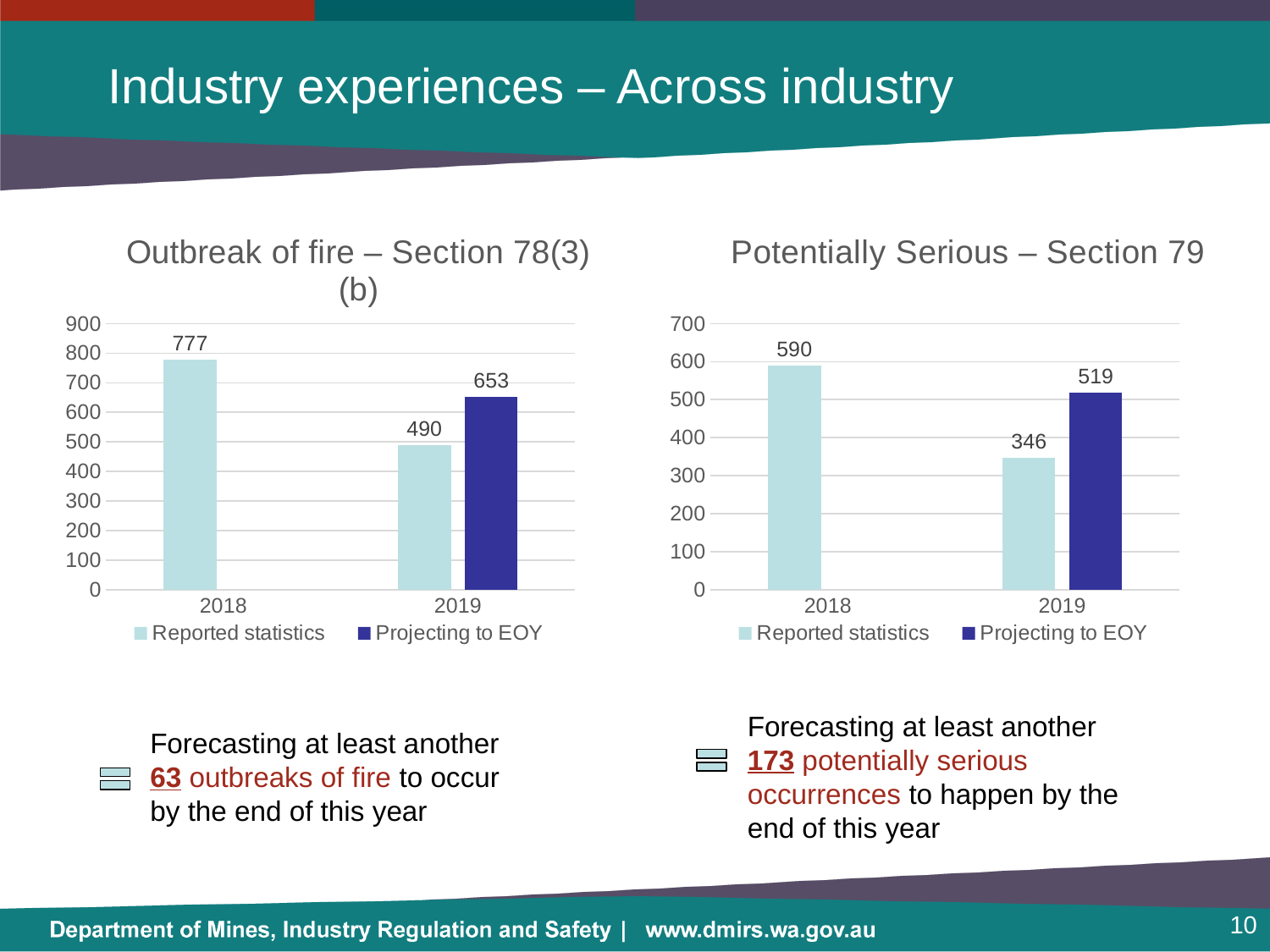
How many series does the legend of the 'Outbreak of fire – Section 78(3)(b)' chart list? 2 What kind of chart is the 'Potentially Serious – Section 79' chart? Bar chart In the 'Outbreak of fire – Section 78(3)(b)' chart, what is the Projecting to EOY value for 2019? 653 In the 'Potentially Serious – Section 79' chart, is the 2018 Reported statistics value greater or less than 500? greater In the 'Outbreak of fire – Section 78(3)(b)' chart, what is the Reported statistics value for 2018? 777 In the 'Outbreak of fire – Section 78(3)(b)' chart, what is the difference between the 2019 Projecting to EOY value and the 2019 Reported statistics value? 163 In the 'Outbreak of fire – Section 78(3)(b)' chart, how many years are shown on the x axis? 2 In the 'Outbreak of fire – Section 78(3)(b)' chart, which bar is the lowest? 2019 Reported statistics In the 'Potentially Serious – Section 79' chart, what is the Reported statistics value for 2019? 346 In the 'Potentially Serious – Section 79' chart, what is the Projecting to EOY value for 2019? 519 In the 'Potentially Serious – Section 79' chart, which year has the higher Reported statistics value? 2018 In the 'Potentially Serious – Section 79' chart, what is the difference between the 2018 Reported statistics value and the 2019 Projecting to EOY value? 71